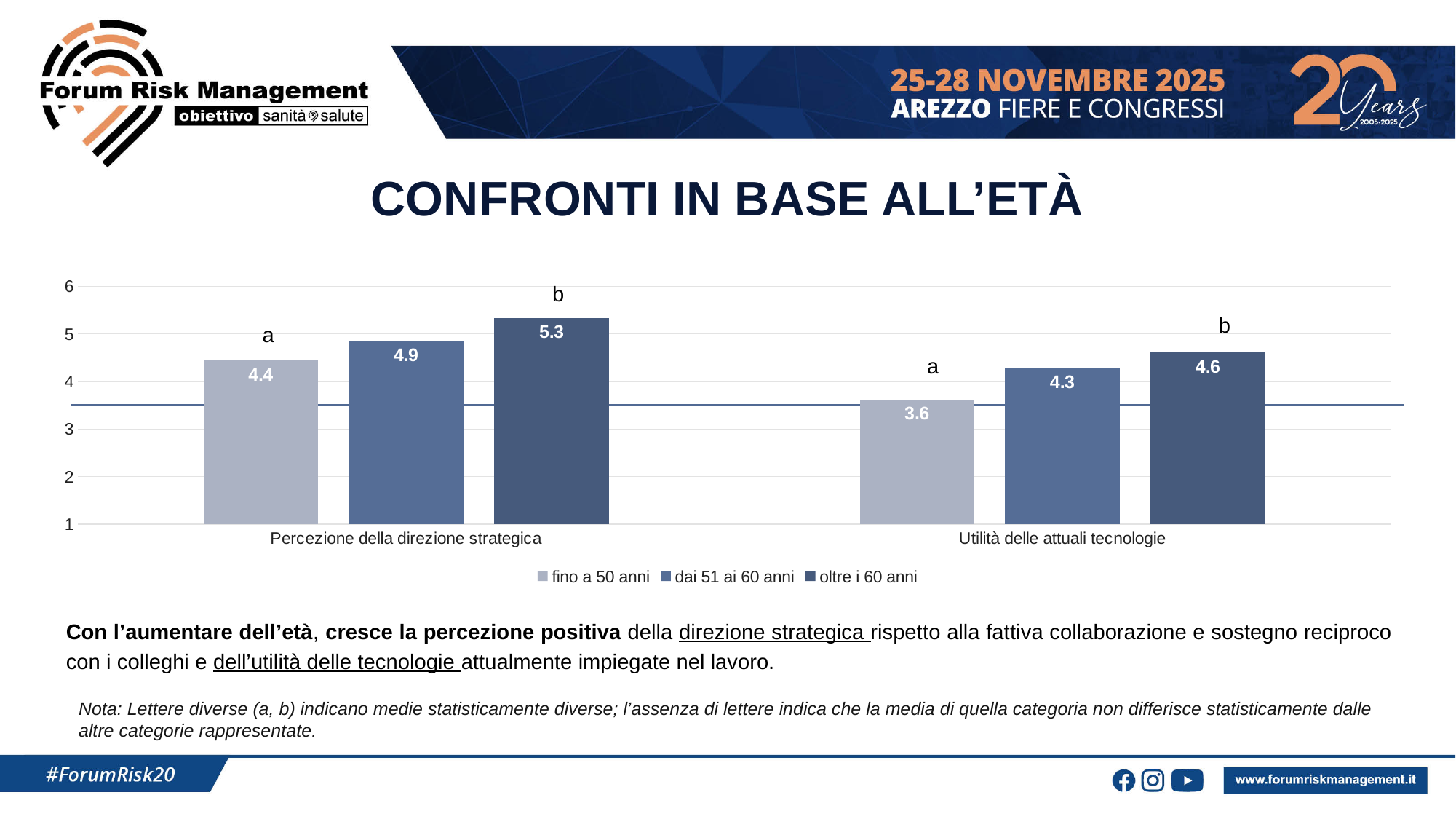
Which age group has the lowest value in the 'Percezione della direzione strategica' category? fino a 50 anni What is the difference between the 'dai 51 ai 60 anni' and 'fino a 50 anni' values in the 'Utilità delle attuali tecnologie' category? 0.7 Which is larger: the 'fino a 50 anni' value for 'Percezione della direzione strategica' or the 'fino a 50 anni' value for 'Utilità delle attuali tecnologie'? Percezione della direzione strategica What is the difference between the 'oltre i 60 anni' and 'fino a 50 anni' values in the 'Percezione della direzione strategica' category? 0.9 Which age group has the highest value in the 'Utilità delle attuali tecnologie' category? oltre i 60 anni What is the value for 'fino a 50 anni' in the 'Percezione della direzione strategica' category? 4.4 How many series does the legend list? 3 What is the value for 'dai 51 ai 60 anni' in the 'Percezione della direzione strategica' category? 4.9 Within each category, do the values rise or fall as the age group increases? rise What kind of chart is shown on the slide? bar chart What is the value for 'oltre i 60 anni' in the 'Utilità delle attuali tecnologie' category? 4.6 How many categories are shown on the x axis? 2